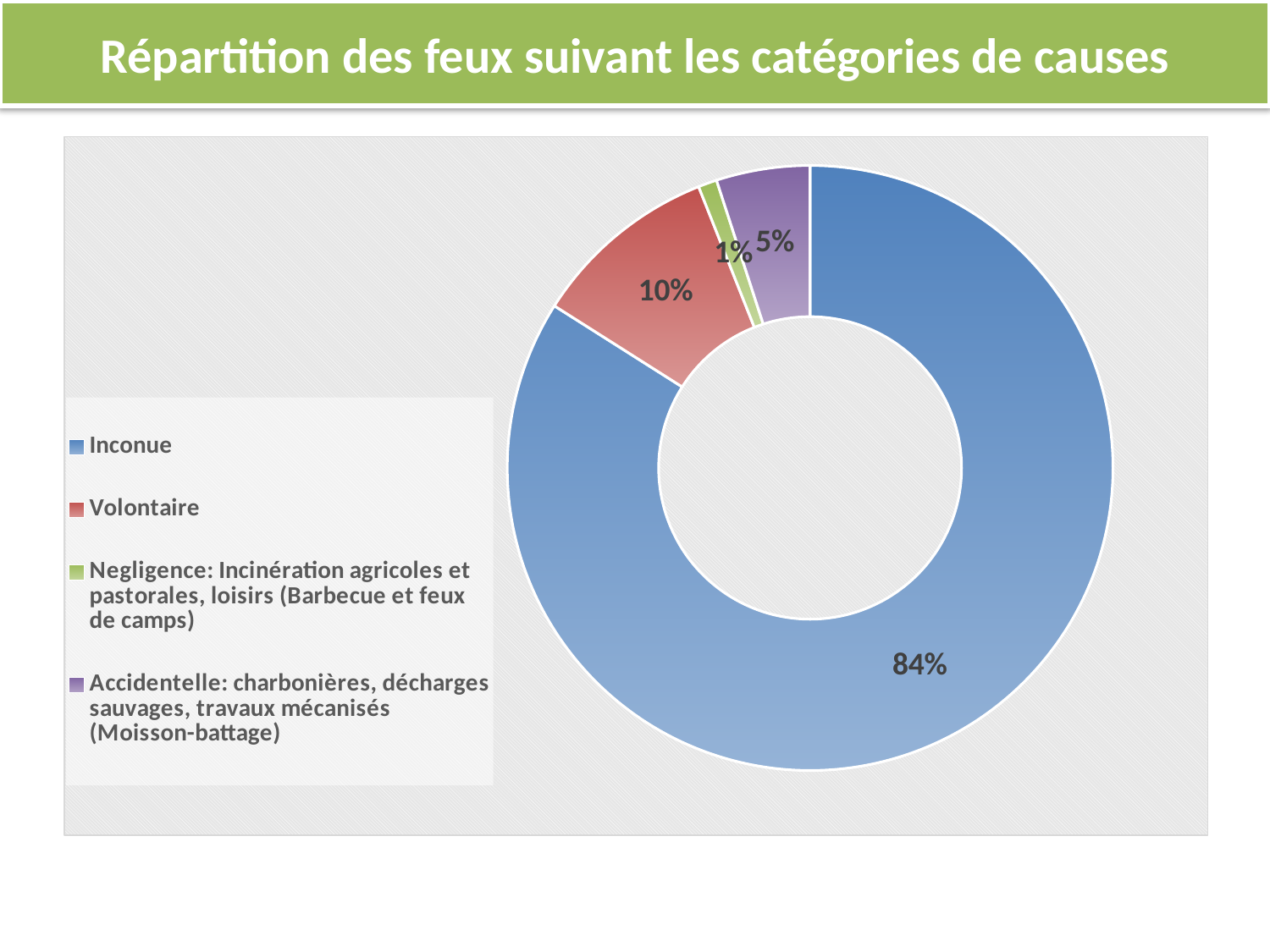
How many categories are shown in the chart? 4 Which category has the largest share of fires? Inconue What share of fires is attributed to the 'Negligence' category? 1% What share of fires is attributed to the 'Volontaire' category? 10% Which category has the smallest share of fires? Negligence: Incinération agricoles et pastorales, loisirs (Barbecue et feux de camps) Which has a larger share, 'Volontaire' or 'Accidentelle'? Volontaire What share of fires is attributed to the 'Inconue' category? 84% What is the title of the slide? Répartition des feux suivant les catégories de causes What kind of chart is shown on the slide? Pie chart (doughnut) What colour represents the 'Volontaire' category? Red What is the difference in percentage points between the 'Inconue' and 'Volontaire' shares? 74